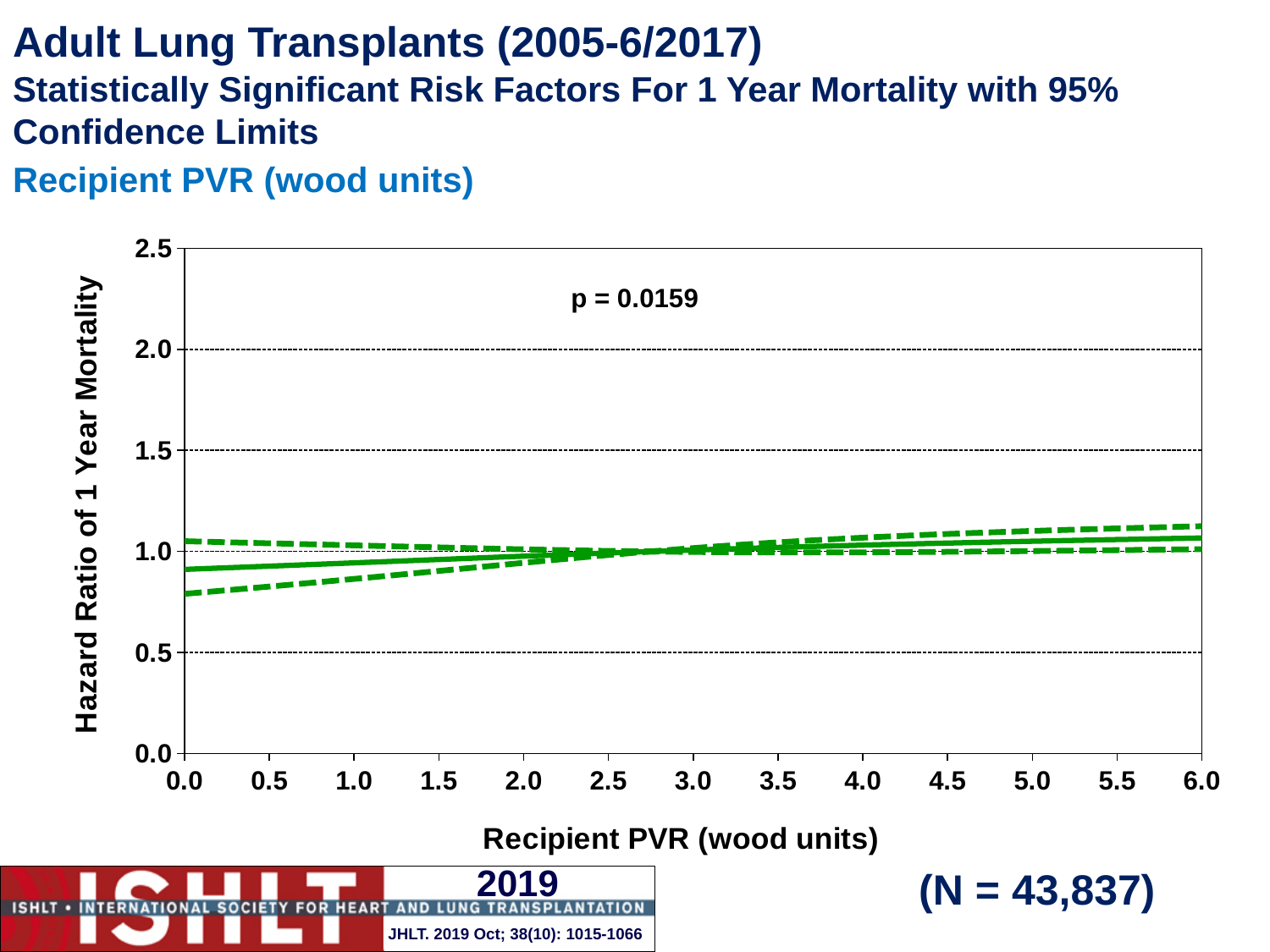
Is the hazard ratio (solid line) at a recipient PVR of 0.0 wood units greater or less than 1.0? less Is the hazard ratio (solid line) at a recipient PVR of 6.0 wood units greater or less than 1.5? less What p-value is printed on the chart? p = 0.0159 What is the sample size (N) shown on the slide? N = 43,837 What kind of chart is shown on the slide? line chart Is the hazard ratio (solid line) at a recipient PVR of 6.0 wood units greater or less than 1.0? greater How many lines are plotted on the chart? 3 Does the hazard ratio of 1 year mortality rise or fall as recipient PVR increases from 0.0 to 6.0 wood units? rise